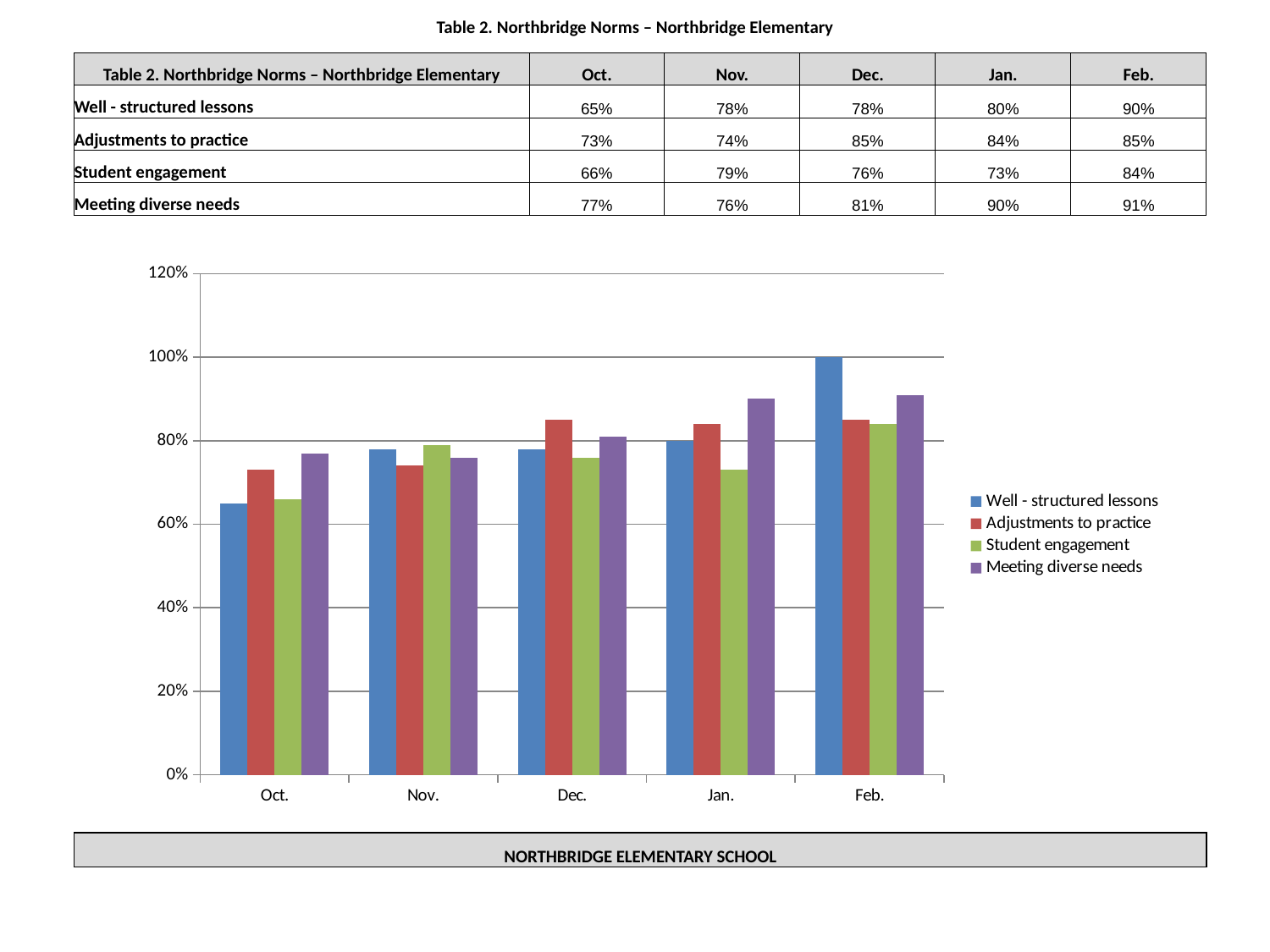
Using the table values, what is the difference between Meeting diverse needs in Jan. and in Oct.? 13 percentage points Does the Meeting diverse needs series rise or fall from Dec. to Feb.? Rises How many months are shown along the x axis of the chart? 5 In Jan., which is larger in the chart: Meeting diverse needs or Student engagement? Meeting diverse needs In the chart, is the value for Meeting diverse needs in Feb. greater or less than 80%? greater What kind of chart is shown below the table? Bar chart How many series does the chart's legend list? 4 In the chart, is the value for Well - structured lessons in Feb. greater or less than 80%? greater In the chart, is the value for Well - structured lessons in Oct. greater or less than 80%? less In which month is the Well - structured lessons bar lowest? Oct. In which month is the Meeting diverse needs bar highest? Feb. According to the table, what is the value for Adjustments to practice in Dec.? 85%